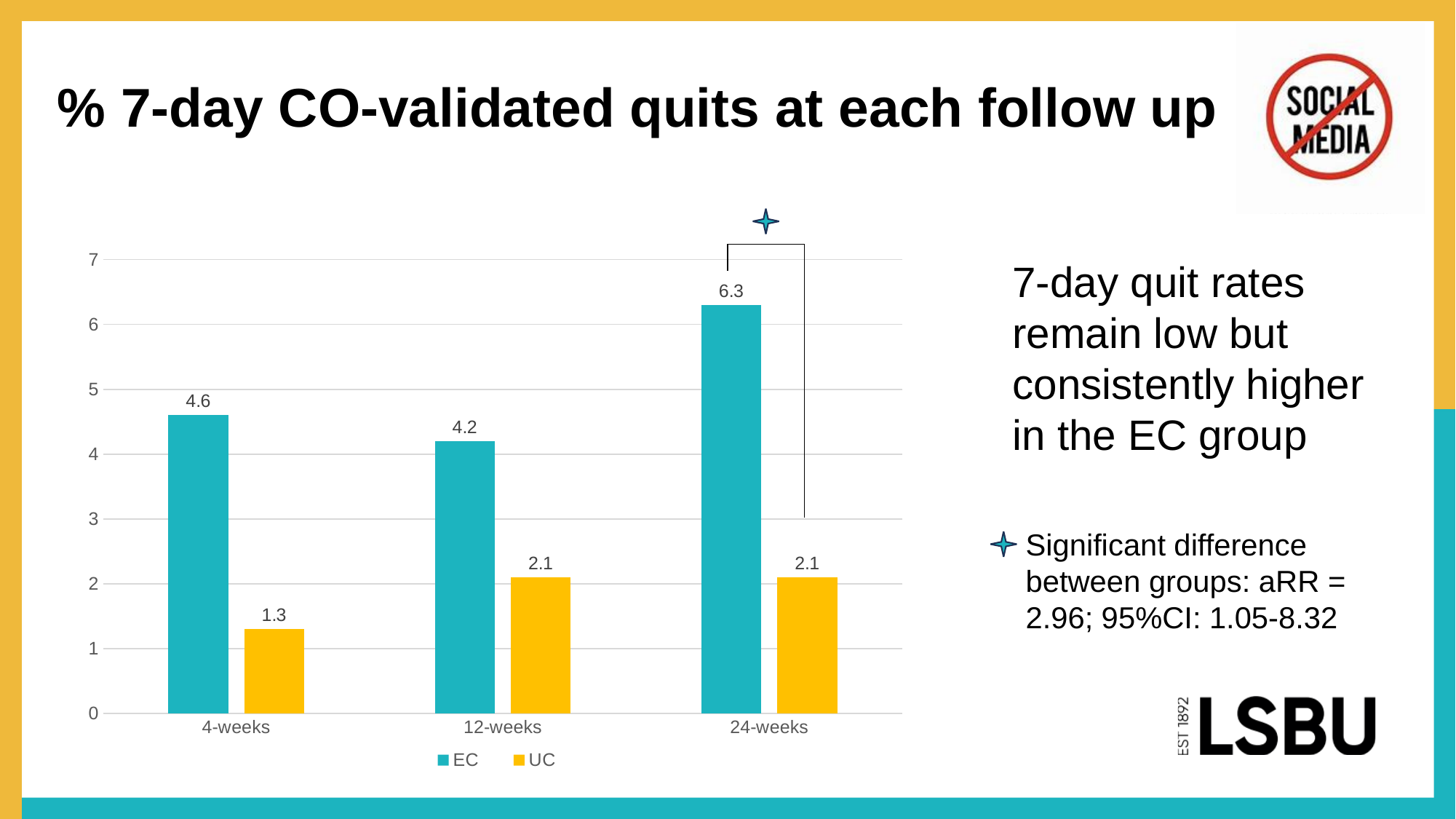
Is the value for EC at 4-weeks greater or less than 4? greater What is the value for EC at 12-weeks? 4.2 What is the value for EC at 24-weeks? 6.3 Which colour represents the UC series? yellow What is the value for UC at 4-weeks? 1.3 What kind of chart is shown on the slide? bar chart Which is larger at 12-weeks, EC or UC? EC At which follow-up is the EC value highest? 24-weeks At which follow-up is the UC value lowest? 4-weeks What is the difference between the EC and UC values at 24-weeks? 4.2 How many series does the legend list? 2 How many follow-up time points are shown on the x axis? 3